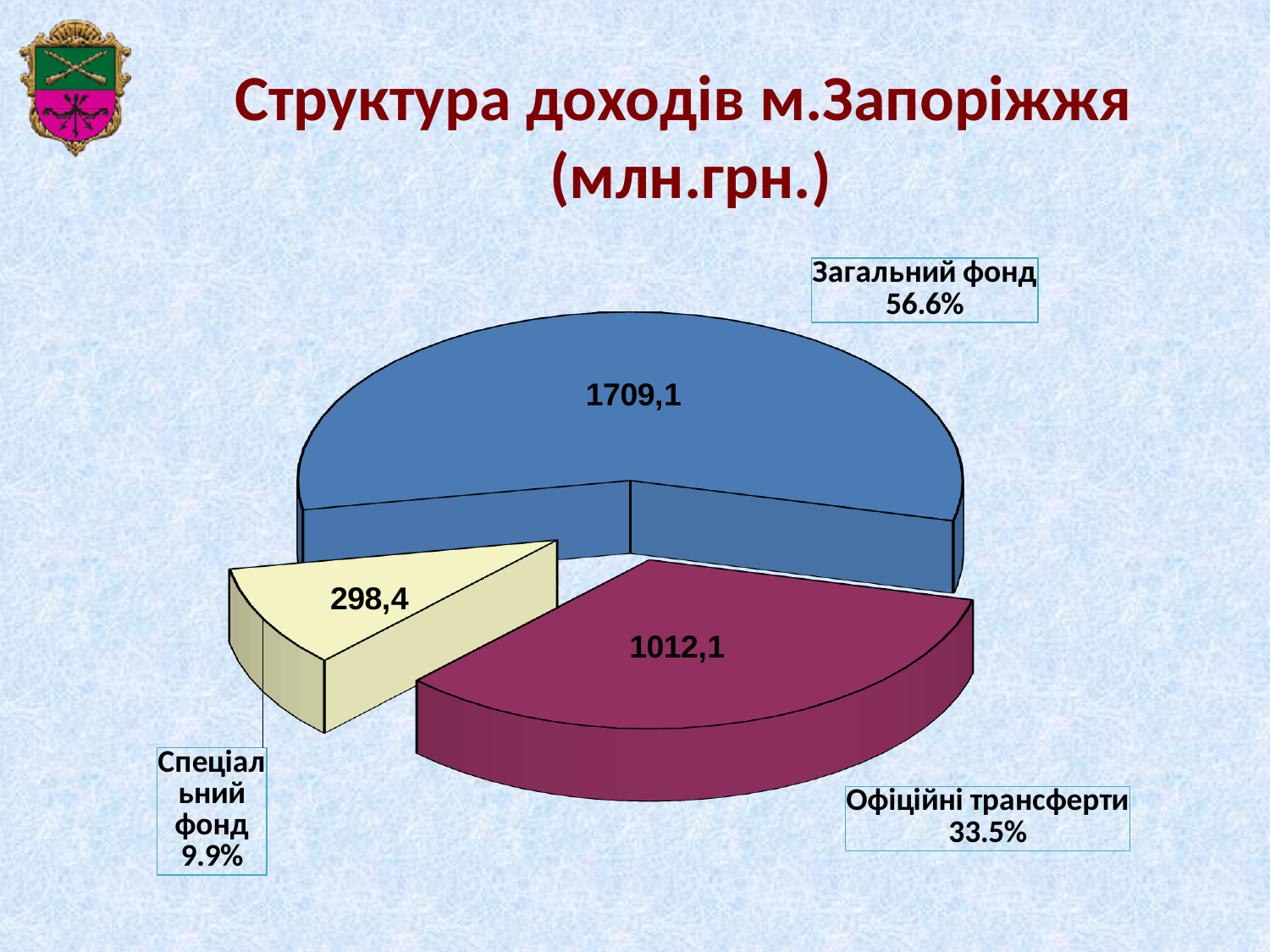
What share of the pie does Загальний фонд represent? 56.6% What is the value for Офіційні трансферти? 1012,1 Which category has the largest slice? Загальний фонд Which category has the smallest slice? Спеціальний фонд What type of chart is shown on the slide? Pie chart What is the title of the chart? Структура доходів м.Запоріжжя (млн.грн.) What share of the pie does Офіційні трансферти represent? 33.5% What is the value for Спеціальний фонд? 298,4 What is the value for Загальний фонд? 1709,1 What is the difference between the values for Загальний фонд and Офіційні трансферти? 697,0 What share of the pie does Спеціальний фонд represent? 9.9% How many slices does the pie chart have? 3